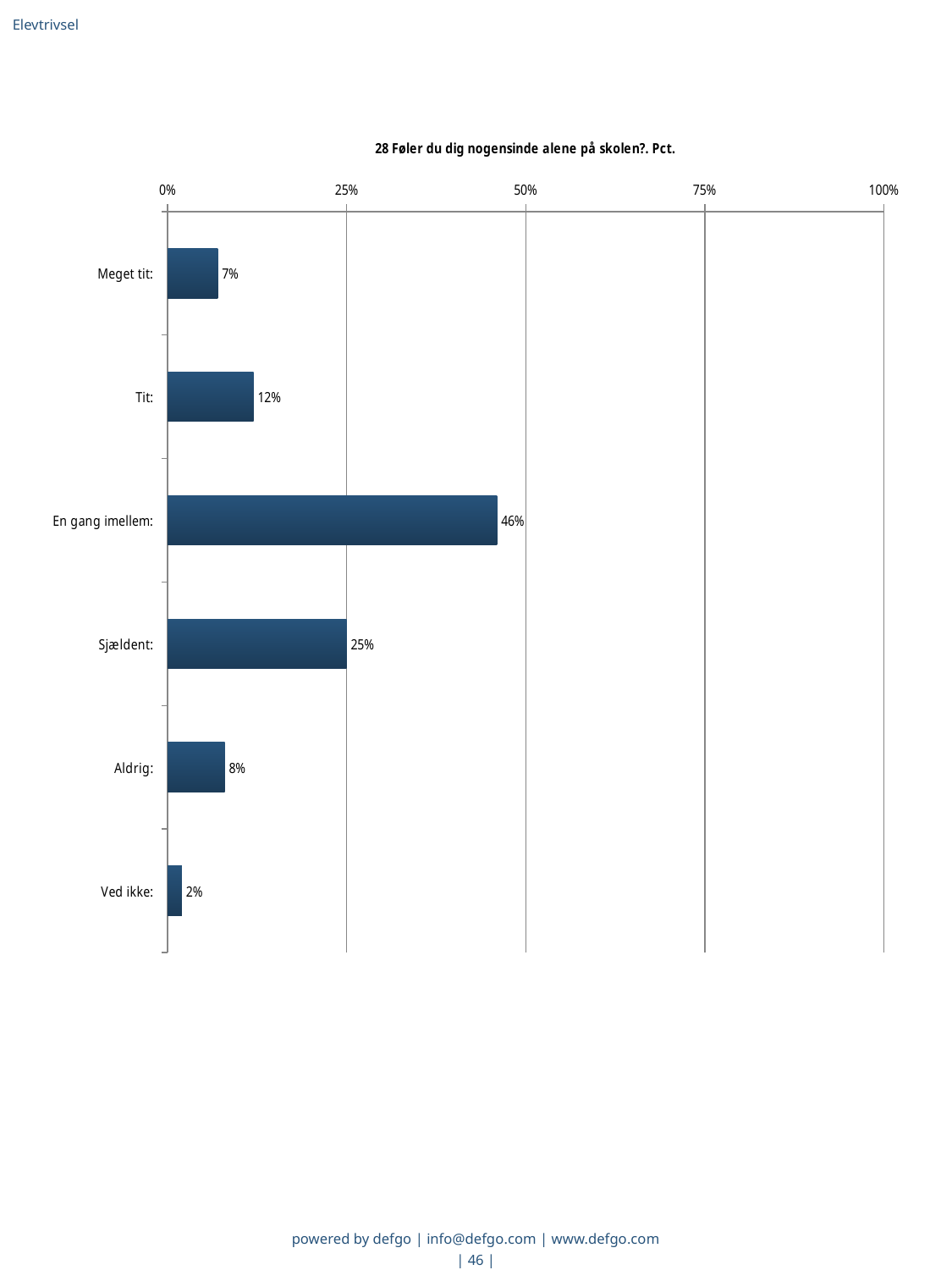
What is the title of the chart? 28 Føler du dig nogensinde alene på skolen?. Pct. Which is larger, the value for "Aldrig" or the value for "Meget tit"? Aldrig What is the value for "Sjældent"? 25% Which category has the lowest value? Ved ikke Which category has the highest value? En gang imellem What is the value for "Tit"? 12% How many categories are shown in the chart? 6 Is the value for "En gang imellem" greater or less than 50%? less What is the difference between the values for "En gang imellem" and "Sjældent"? 21% What is the value for "Ved ikke"? 2% What kind of chart is shown on the slide? bar chart What is the value for "En gang imellem"? 46%